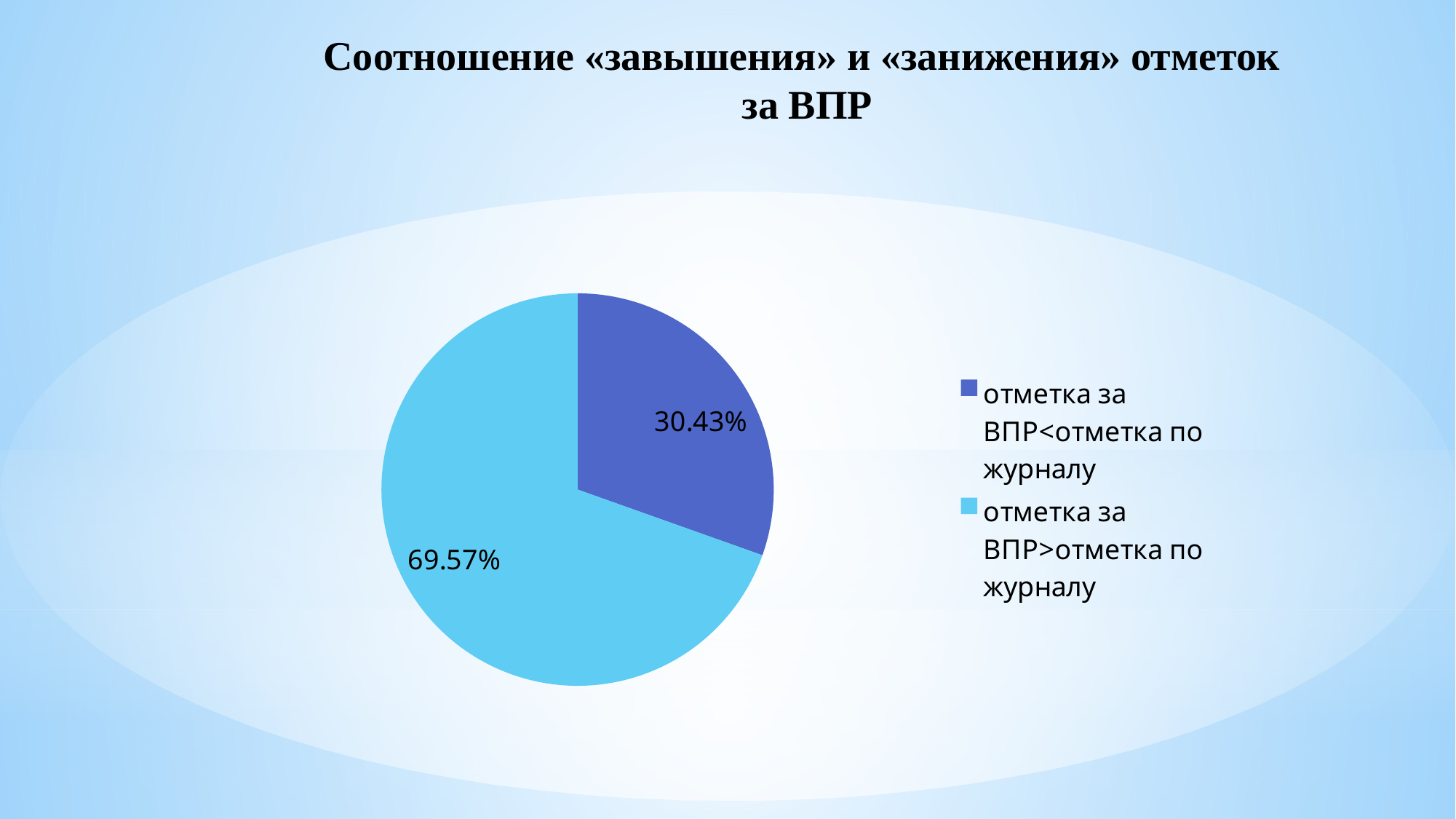
What is the difference in percentage points between the two slices of the pie? 39.14 Which slice of the pie is the largest? отметка за ВПР>отметка по журналу How many entries does the legend list? 2 What colour is the slice for "отметка за ВПР>отметка по журналу"? light blue Which is larger: the slice for "отметка за ВПР<отметка по журналу" or the slice for "отметка за ВПР>отметка по журналу"? отметка за ВПР>отметка по журналу What is the title of the chart on the slide? Соотношение «завышения» и «занижения» отметок за ВПР What share of the pie is labelled "отметка за ВПР<отметка по журналу"? 30.43% How many slices does the pie chart have? 2 Which slice of the pie is the smallest? отметка за ВПР<отметка по журналу What share of the pie is labelled "отметка за ВПР>отметка по журналу"? 69.57% What kind of chart is shown on the slide? pie chart